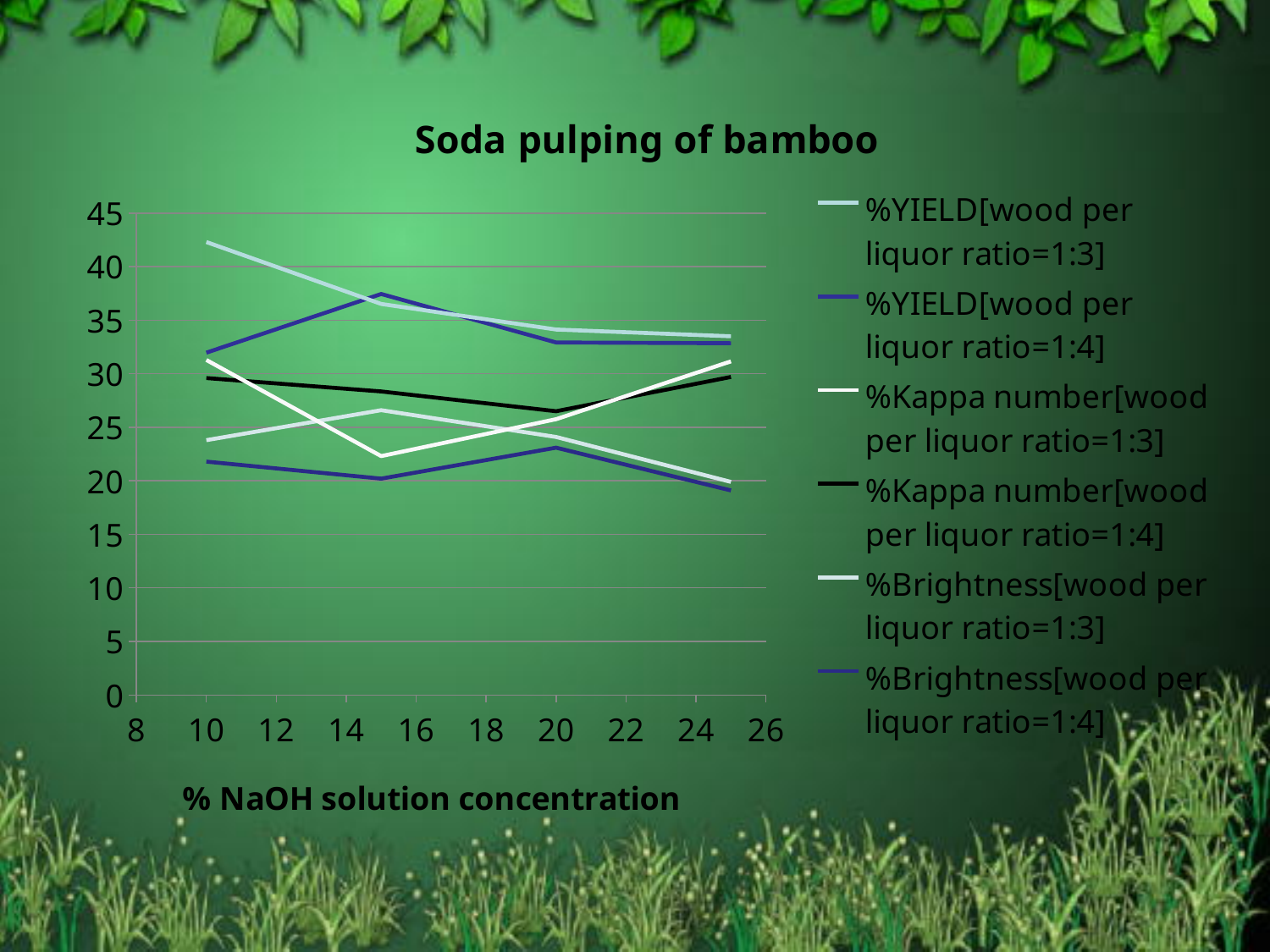
Is the value of %YIELD[wood per liquor ratio=1:4] at 15% NaOH greater or less than 35? greater What is the title of the chart? Soda pulping of bamboo What kind of chart is shown on the slide? line chart How many series does the legend list? 6 Is the value of %Kappa number[wood per liquor ratio=1:3] at 15% NaOH greater or less than 25? less Is the value of %Kappa number[wood per liquor ratio=1:4] at 10% NaOH greater or less than 25? greater Does %YIELD[wood per liquor ratio=1:3] rise or fall as the NaOH concentration increases from 10 to 25? fall How many data points are plotted for each series? 4 What is the label of the x axis? % NaOH solution concentration